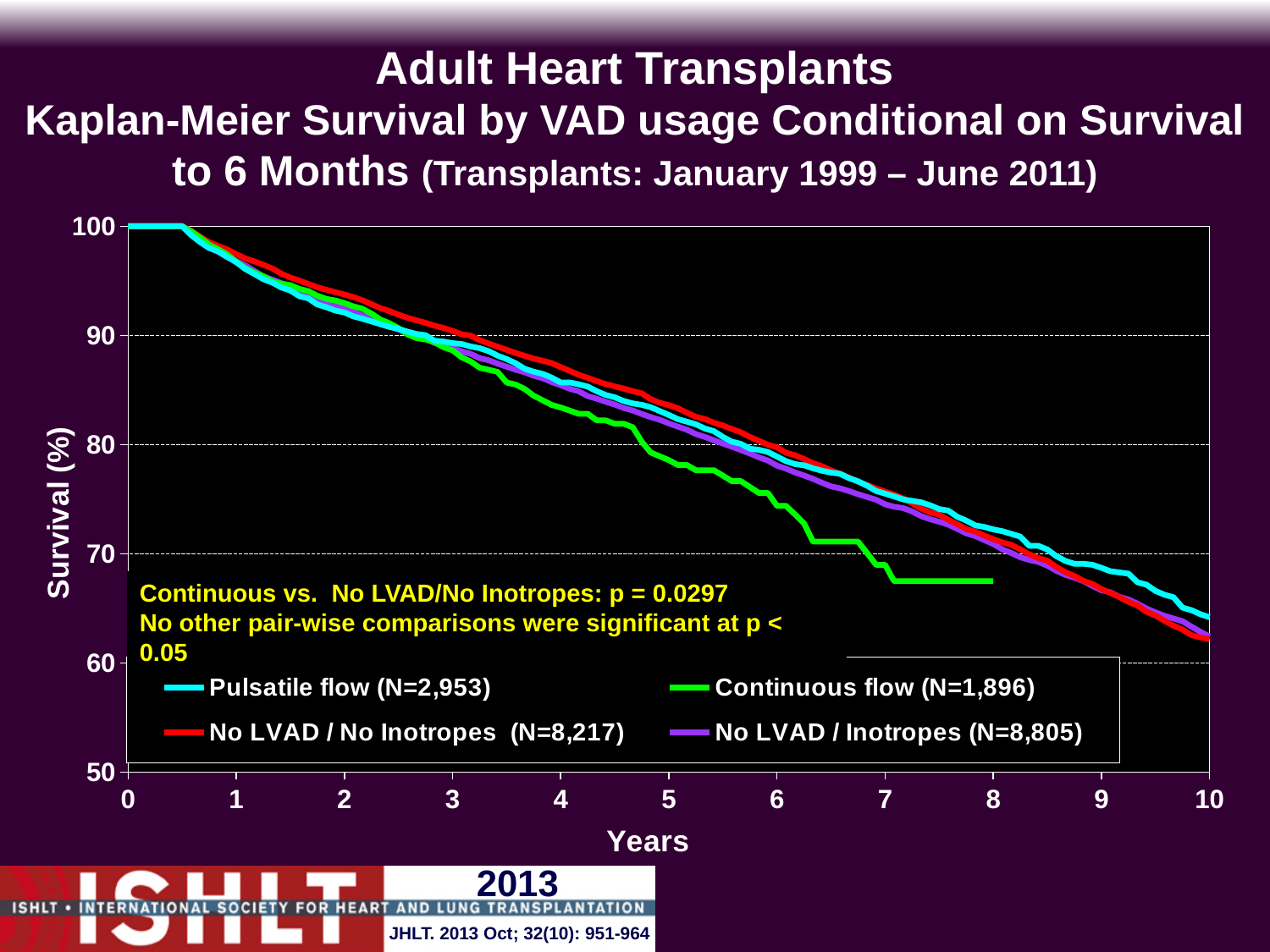
Is the survival value for Pulsatile flow at 10 years greater or less than 70? less At 7 years, which series has higher survival: No LVAD / No Inotropes or Continuous flow? No LVAD / No Inotropes How many series does the legend list? 4 At 6 years, which series has higher survival: Pulsatile flow or Continuous flow? Pulsatile flow Is the survival value for No LVAD / No Inotropes at 1 year greater or less than 90? greater Is the survival value for Continuous flow at 8 years greater or less than 70? less What is the sample size (N) shown in the legend for the Continuous flow series? N=1,896 Do the survival curves rise or fall as years increase along the x axis? fall Which series has the lowest survival at 8 years? Continuous flow What kind of chart is shown on the slide? line chart What p-value is reported for the comparison of Continuous vs. No LVAD/No Inotropes? p = 0.0297